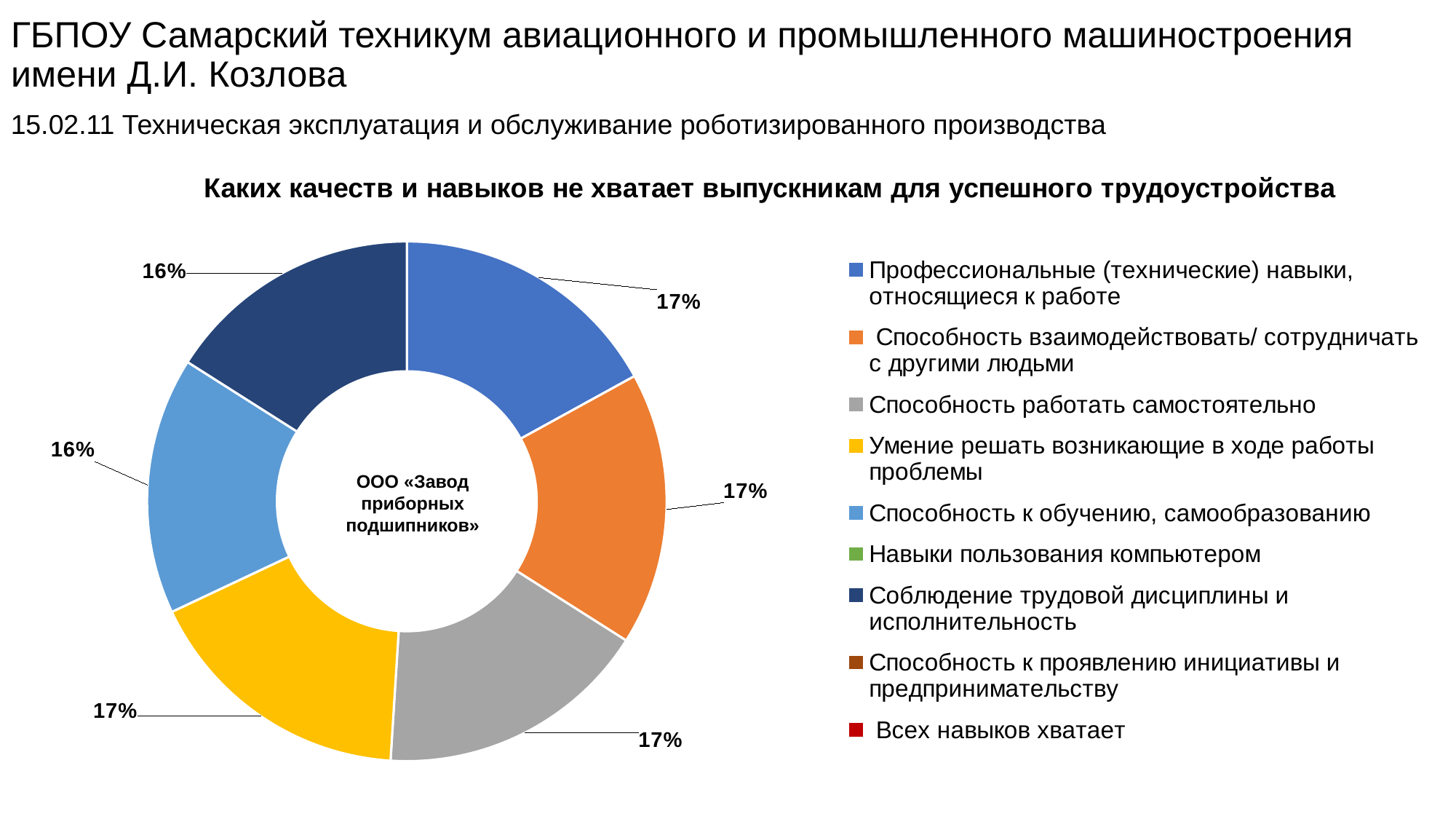
What is the difference between the share for "Способность работать самостоятельно" and the share for "Соблюдение трудовой дисциплины и исполнительность"? 1% What share is shown for "Соблюдение трудовой дисциплины и исполнительность"? 16% What share of the chart is labelled for "Профессиональные (технические) навыки, относящиеся к работе"? 17% What share is shown for "Способность к обучению, самообразованию"? 16% What share is shown for "Способность работать самостоятельно"? 17% What is the title of the chart? Каких качеств и навыков не хватает выпускникам для успешного трудоустройства How many slices with data labels are visible in the doughnut chart? 6 What share is shown for "Умение решать возникающие в ходе работы проблемы"? 17% How many entries does the legend list? 9 What kind of chart is shown on the slide? Doughnut (pie) chart What text is written in the centre of the doughnut chart? ООО «Завод приборных подшипников» Which is larger: the share for "Способность взаимодействовать/ сотрудничать с другими людьми" or the share for "Способность к обучению, самообразованию"? Способность взаимодействовать/ сотрудничать с другими людьми